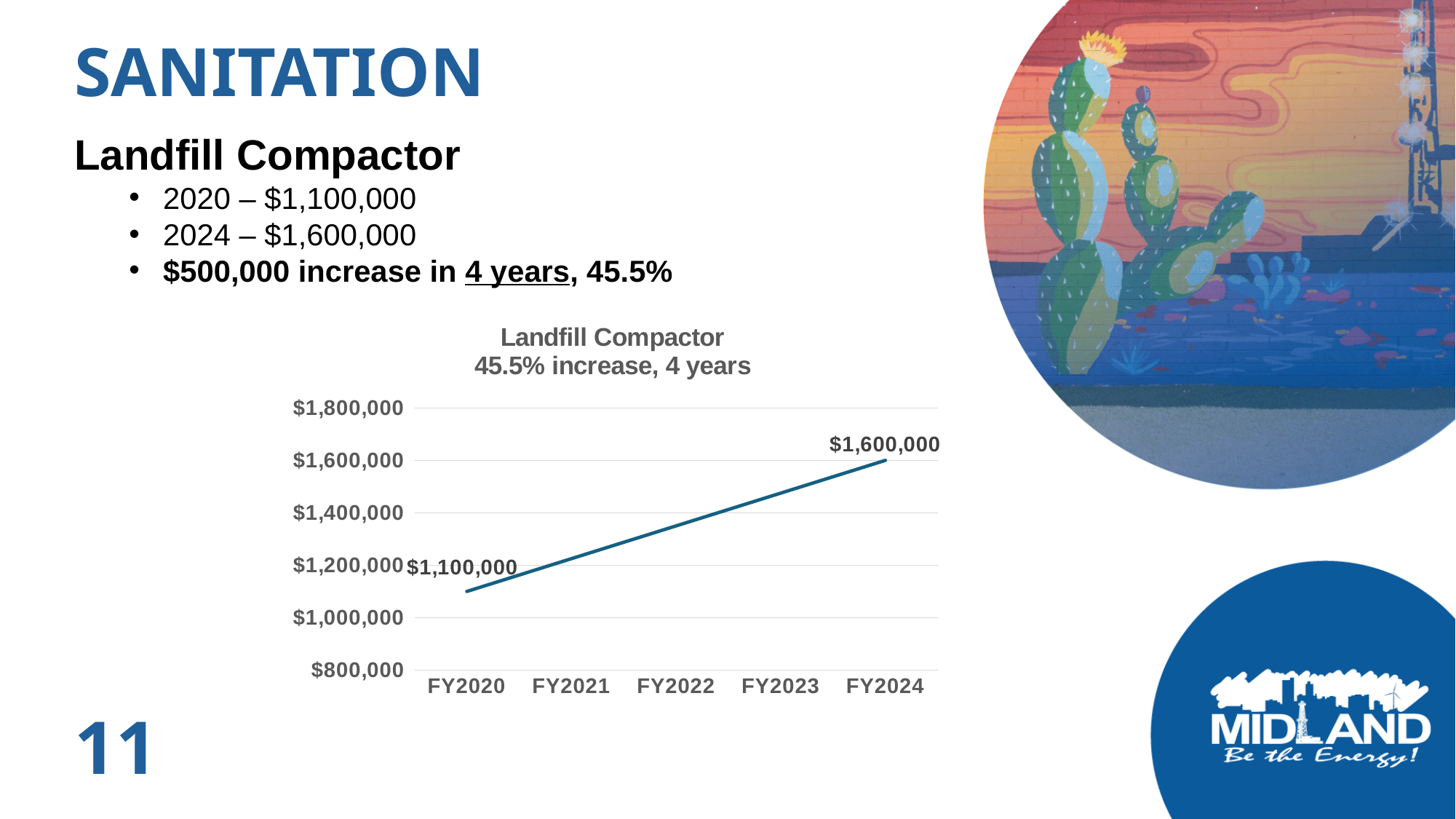
What is the difference between the FY2024 and FY2020 values in the Landfill Compactor chart? $500,000 Which is larger in the Landfill Compactor chart, the FY2020 value or the FY2024 value? FY2024 What percentage increase is stated in the title of the Landfill Compactor chart? 45.5% Is the value for FY2020 in the Landfill Compactor chart greater or less than $1,200,000? less Which fiscal year has the lowest value in the Landfill Compactor chart? FY2020 How many fiscal years are shown on the x axis of the Landfill Compactor chart? 5 Is the value for FY2022 in the Landfill Compactor chart greater or less than $1,200,000? greater What is the value for FY2020 in the Landfill Compactor chart? $1,100,000 What kind of chart is the Landfill Compactor chart? line chart Do the values in the Landfill Compactor chart rise or fall from FY2020 to FY2024? rise Which fiscal year has the highest value in the Landfill Compactor chart? FY2024 What is the value for FY2024 in the Landfill Compactor chart? $1,600,000